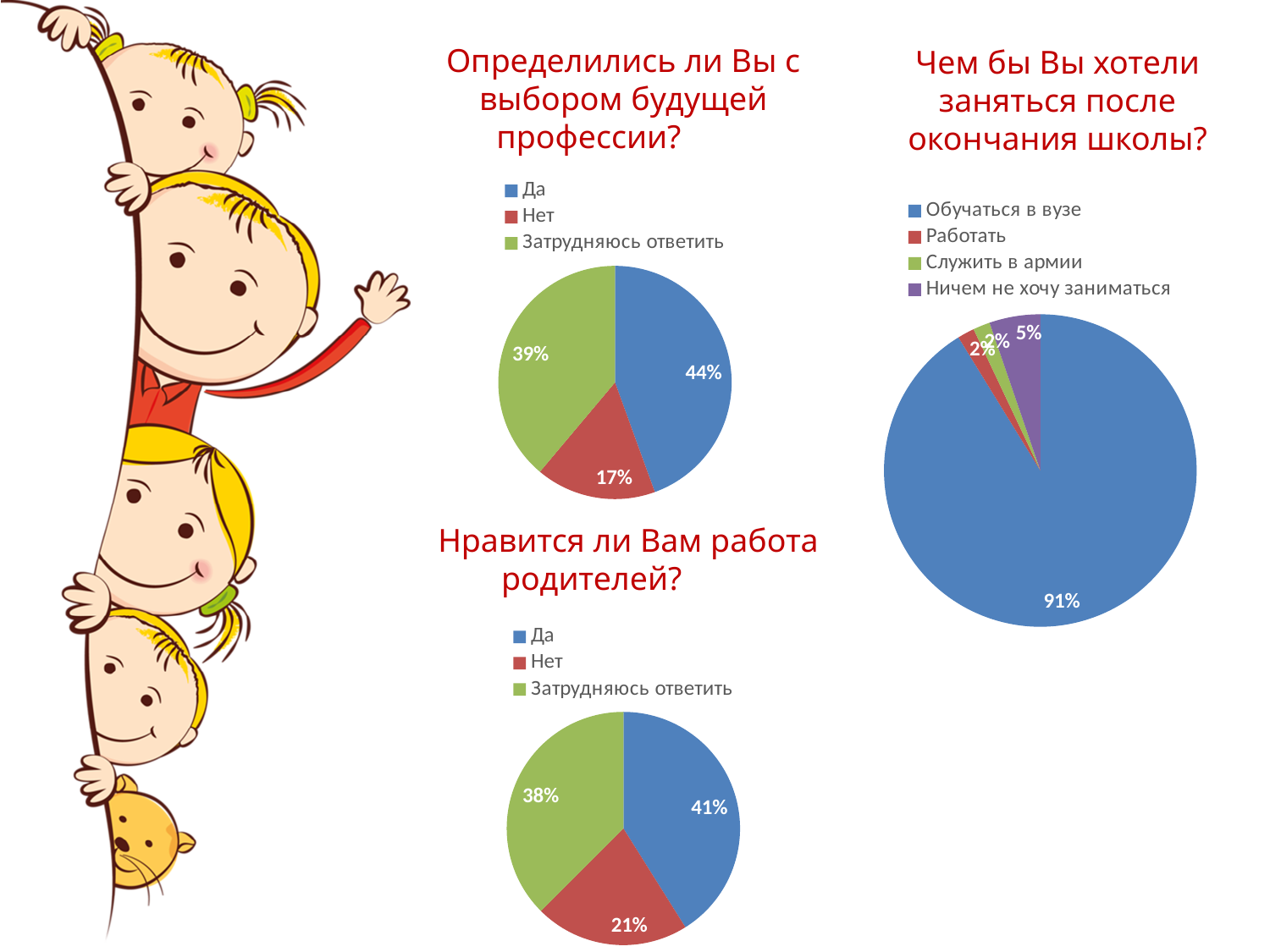
In the chart titled "Нравится ли Вам работа родителей?", what is the difference between the shares for "Да" and "Нет"? 20% What type of chart is used for "Чем бы Вы хотели заняться после окончания школы?"? Pie chart In the chart titled "Определились ли Вы с выбором будущей профессии?", which answer has the smallest share? Нет In the chart titled "Определились ли Вы с выбором будущей профессии?", what is the difference between the shares for "Да" and "Затрудняюсь ответить"? 5% In the chart titled "Чем бы Вы хотели заняться после окончания школы?", what share of respondents chose "Ничем не хочу заниматься"? 5% In the chart titled "Определились ли Вы с выбором будущей профессии?", what share of respondents answered "Нет"? 17% In the chart titled "Нравится ли Вам работа родителей?", which answer has the largest share? Да In the chart titled "Определились ли Вы с выбором будущей профессии?", what share of respondents answered "Да"? 44% In the chart titled "Нравится ли Вам работа родителей?", what share of respondents answered "Затрудняюсь ответить"? 38% In the chart titled "Чем бы Вы хотели заняться после окончания школы?", what share of respondents chose "Обучаться в вузе"? 91% In the chart titled "Чем бы Вы хотели заняться после окончания школы?", how many categories does the legend list? 4 In the chart titled "Нравится ли Вам работа родителей?", which is larger: the share for "Нет" or the share for "Затрудняюсь ответить"? Затрудняюсь ответить